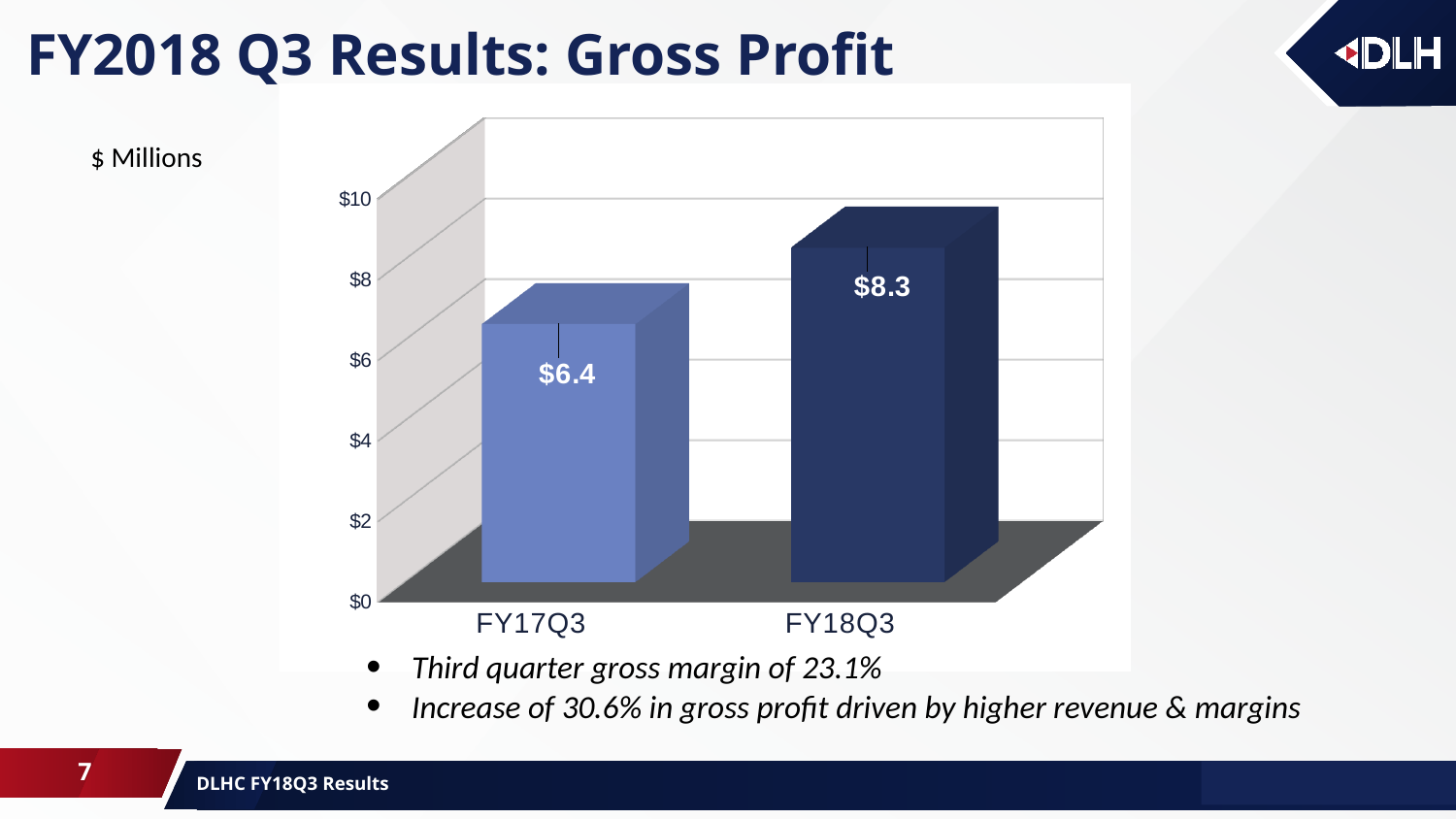
Is the value for FY17Q3 greater or less than $8? less What kind of chart is shown on the slide? bar chart How many quarters are shown on the chart? 2 What is the gross profit value for FY17Q3? $6.4 What is the difference in gross profit between FY18Q3 and FY17Q3? $1.9 What is the gross profit value for FY18Q3? $8.3 Is the value for FY18Q3 greater or less than $8? greater In what units are the chart values expressed? $ Millions Which quarter has the higher gross profit? FY18Q3 Which quarter has the lower gross profit? FY17Q3 Is the gross profit for FY18Q3 larger or smaller than for FY17Q3? larger Do the values rise or fall from FY17Q3 to FY18Q3? rise